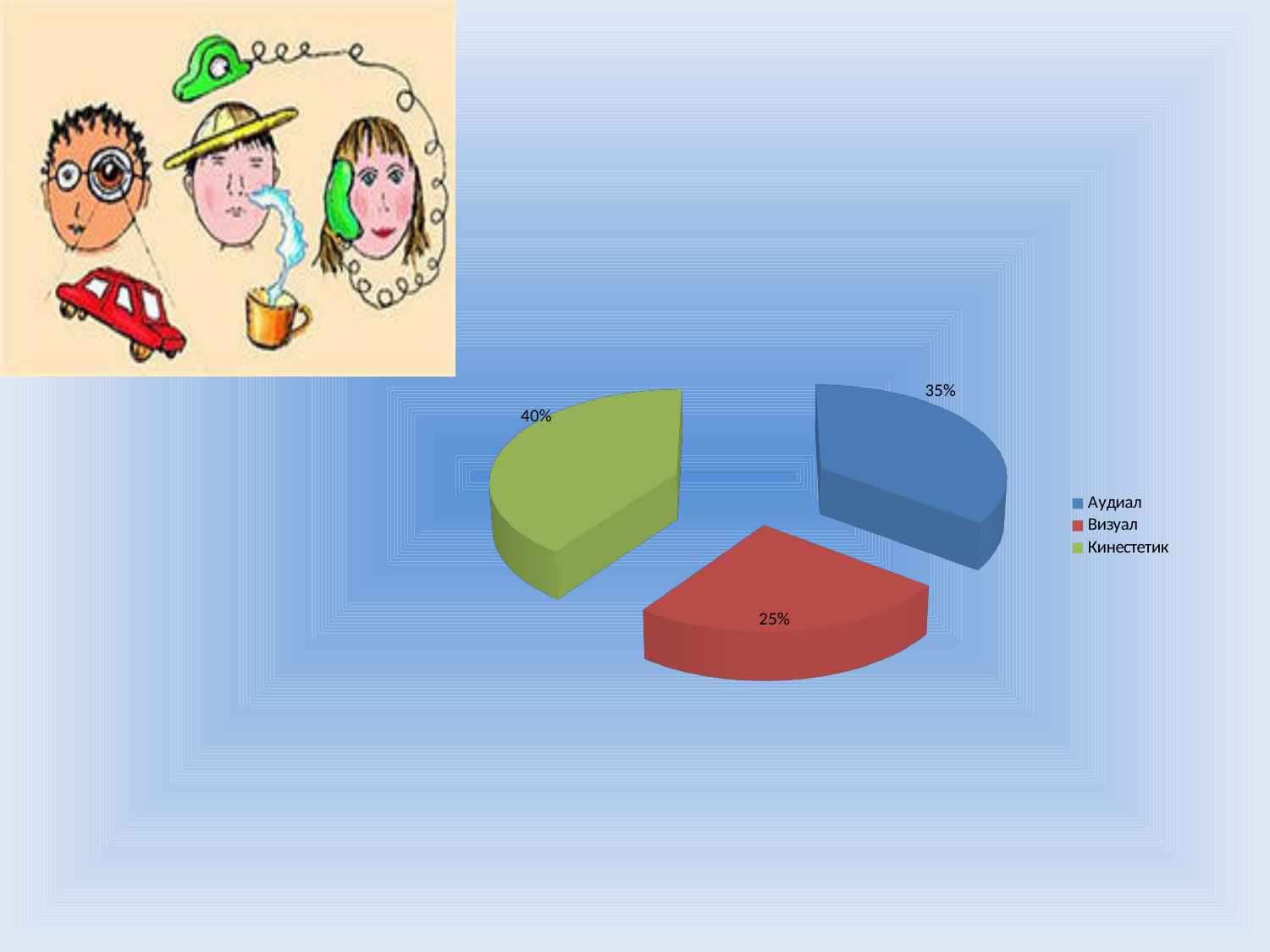
What colour is the slice for Визуал? Red How many categories does the pie chart have? 3 Which is larger, the share of Аудиал or the share of Визуал? Аудиал What is the value for Аудиал? 35% What is the difference between the shares of Кинестетик and Аудиал? 5% What is the value for Кинестетик? 40% What is the value for Визуал? 25% Which category is shown in green in the legend? Кинестетик What kind of chart is shown on the slide? Pie chart Which category has the smallest share of the pie? Визуал Which category has the largest share of the pie? Кинестетик What is the difference between the shares of Кинестетик and Визуал? 15%